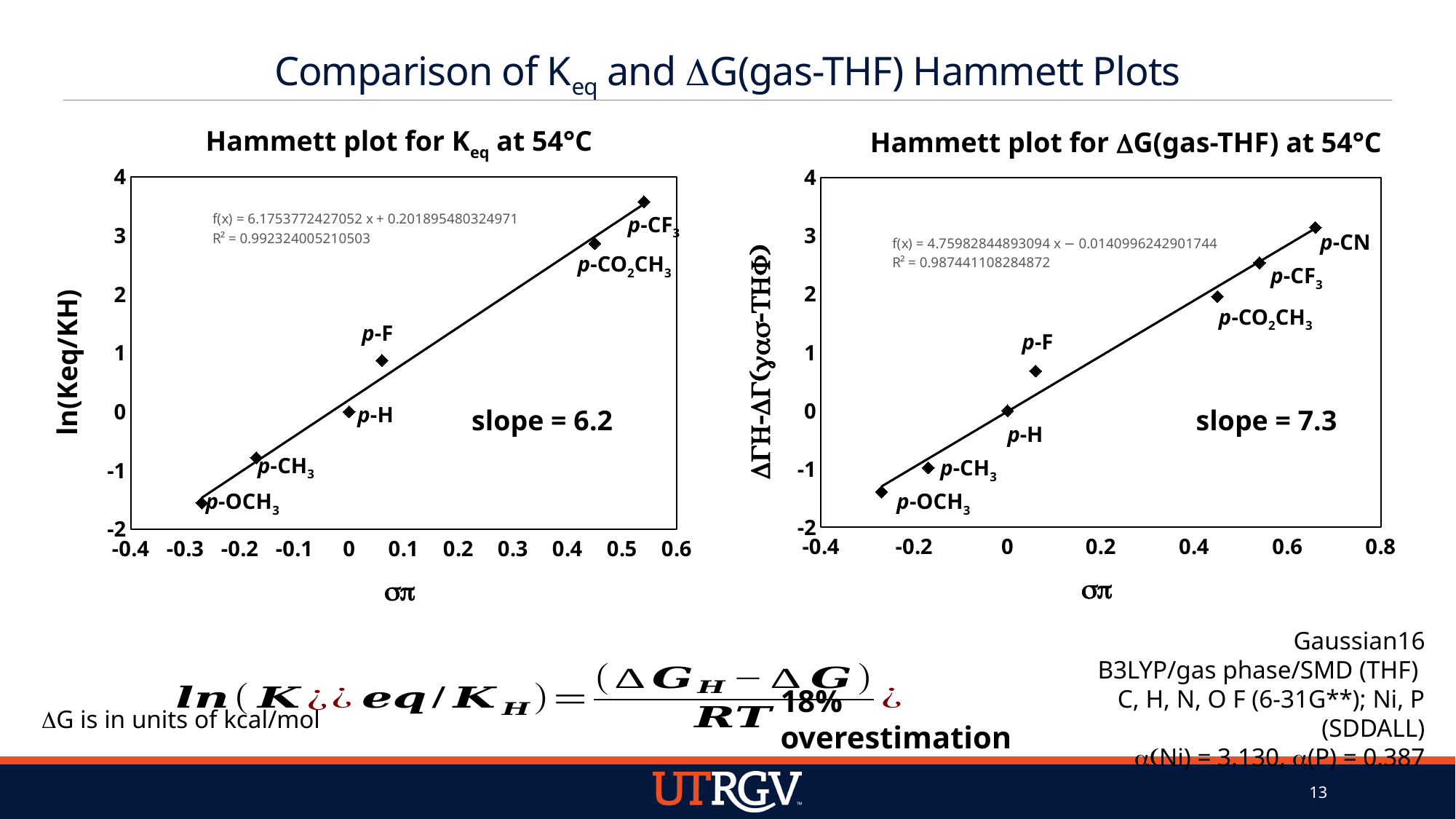
How many data points are plotted in the 'Hammett plot for ΔG(gas-THF) at 54°C'? 7 How many data points are plotted in the 'Hammett plot for Keq at 54°C'? 6 In the 'Hammett plot for Keq at 54°C', is the value for p-CF3 greater or less than 3? greater What kind of chart is the 'Hammett plot for Keq at 54°C'? scatter chart In the 'Hammett plot for ΔG(gas-THF) at 54°C', which labelled substituent has the lowest y value? p-OCH3 In the 'Hammett plot for Keq at 54°C', which labelled substituent has the lowest ln(Keq/KH) value? p-OCH3 In the 'Hammett plot for Keq at 54°C', which has the larger y value, p-F or p-CH3? p-F In the 'Hammett plot for ΔG(gas-THF) at 54°C', which labelled substituent has the highest y value? p-CN What slope is annotated on the 'Hammett plot for ΔG(gas-THF) at 54°C'? slope = 7.3 Do the plotted values in the 'Hammett plot for ΔG(gas-THF) at 54°C' rise or fall as σπ increases? rise In the 'Hammett plot for Keq at 54°C', which labelled substituent has the highest ln(Keq/KH) value? p-CF3